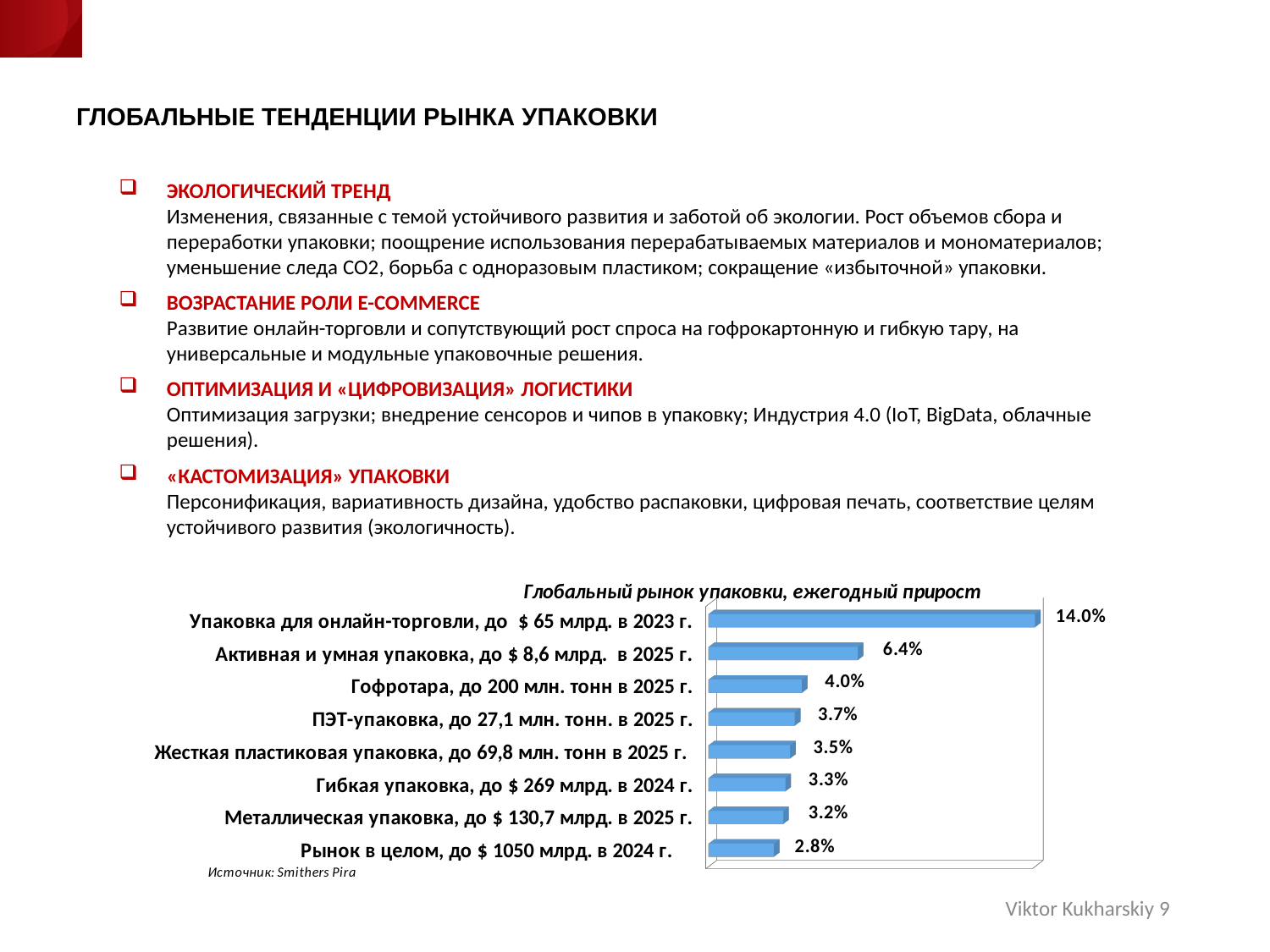
What is the difference between the annual growth for 'Упаковка для онлайн-торговли' and 'Активная и умная упаковка'? 7.6% What is the annual growth value shown for 'Гофротара, до 200 млн. тонн в 2025 г.'? 4.0% Which has a larger annual growth: 'ПЭТ-упаковка' or 'Металлическая упаковка'? ПЭТ-упаковка What is the annual growth value shown for 'Упаковка для онлайн-торговли, до $ 65 млрд. в 2023 г.'? 14.0% Which category has the lowest annual growth in the chart? Рынок в целом, до $ 1050 млрд. в 2024 г. Which category has the highest annual growth in the chart? Упаковка для онлайн-торговли, до $ 65 млрд. в 2023 г. What kind of chart is shown on the slide? Bar chart How many categories are shown in the chart? 8 What is the title of the chart? Глобальный рынок упаковки, ежегодный прирост What is the annual growth value shown for 'Гибкая упаковка, до $ 269 млрд. в 2024 г.'? 3.3% What is the annual growth value shown for 'Рынок в целом, до $ 1050 млрд. в 2024 г.'? 2.8% What source is cited for the chart? Smithers Pira